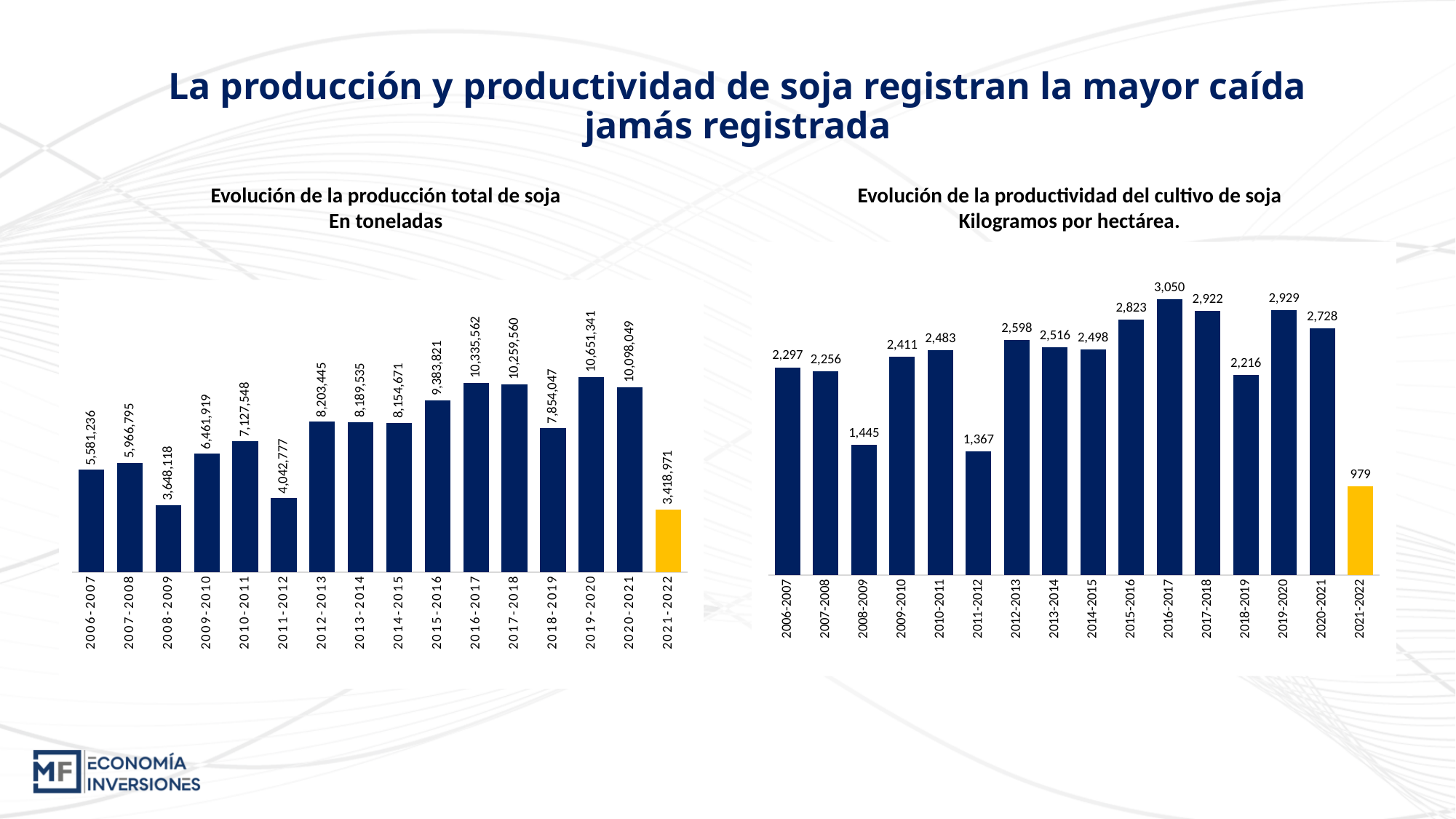
What kind of chart is the right chart (Evolución de la productividad del cultivo de soja)? Bar chart In the left chart (Evolución de la producción total de soja), what is the difference between the 2020-2021 and 2021-2022 values? 6,679,078 How many seasons are plotted in the left chart (Evolución de la producción total de soja)? 16 In the left chart (Evolución de la producción total de soja), which is larger, the value for 2008-2009 or for 2011-2012? 2011-2012 In the right chart (Evolución de la productividad del cultivo de soja), what is the difference between the 2020-2021 and 2021-2022 values? 1,749 In the left chart (Evolución de la producción total de soja), what colour is the bar for 2021-2022? Yellow In the left chart (Evolución de la producción total de soja), what is the value for 2021-2022? 3,418,971 In the right chart (Evolución de la productividad del cultivo de soja), which is larger, the value for 2017-2018 or for 2018-2019? 2017-2018 In the left chart (Evolución de la producción total de soja), which season has the highest production? 2019-2020 In the right chart (Evolución de la productividad del cultivo de soja), what is the value for 2016-2017? 3,050 In the right chart (Evolución de la productividad del cultivo de soja), what is the value for 2011-2012? 1,367 In the right chart (Evolución de la productividad del cultivo de soja), which season has the lowest productivity? 2021-2022